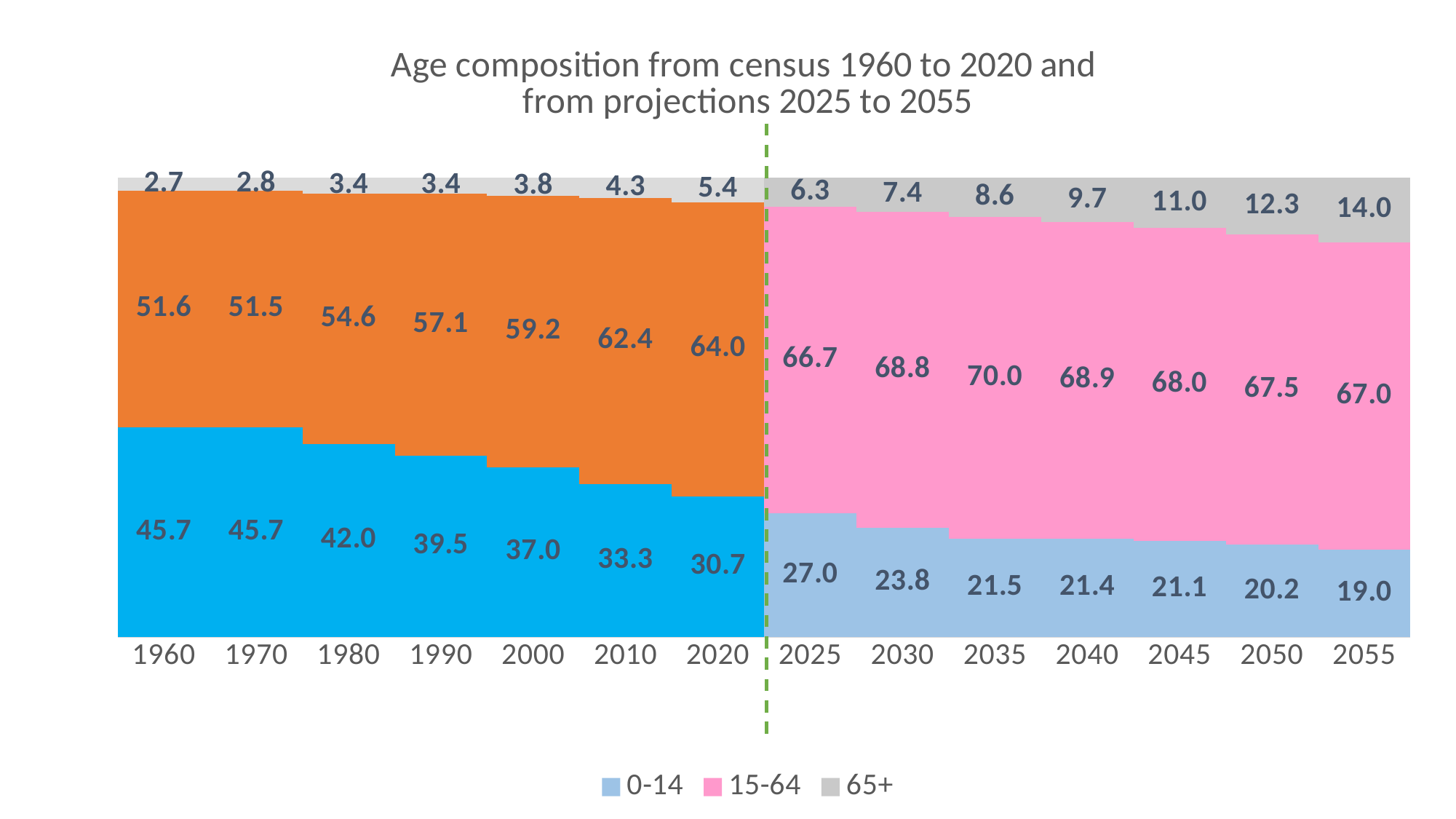
What is the value for the 65+ group in 2020? 5.4 Which is larger, the 15-64 value in 2030 or in 2050? 2030 Does the 65+ value rise or fall from 1960 to 2055? rise In which year is the 0-14 value lowest? 2055 What is the difference between the 0-14 value in 1960 and in 2020? 15.0 What kind of chart is this? stacked bar chart What is the value for the 15-64 group in 2035? 70.0 How many series does the legend list? 3 How many years are shown on the x axis? 14 In which year is the 65+ value highest? 2055 What is the title of the chart? Age composition from census 1960 to 2020 and from projections 2025 to 2055 What is the value for the 0-14 group in 1990? 39.5